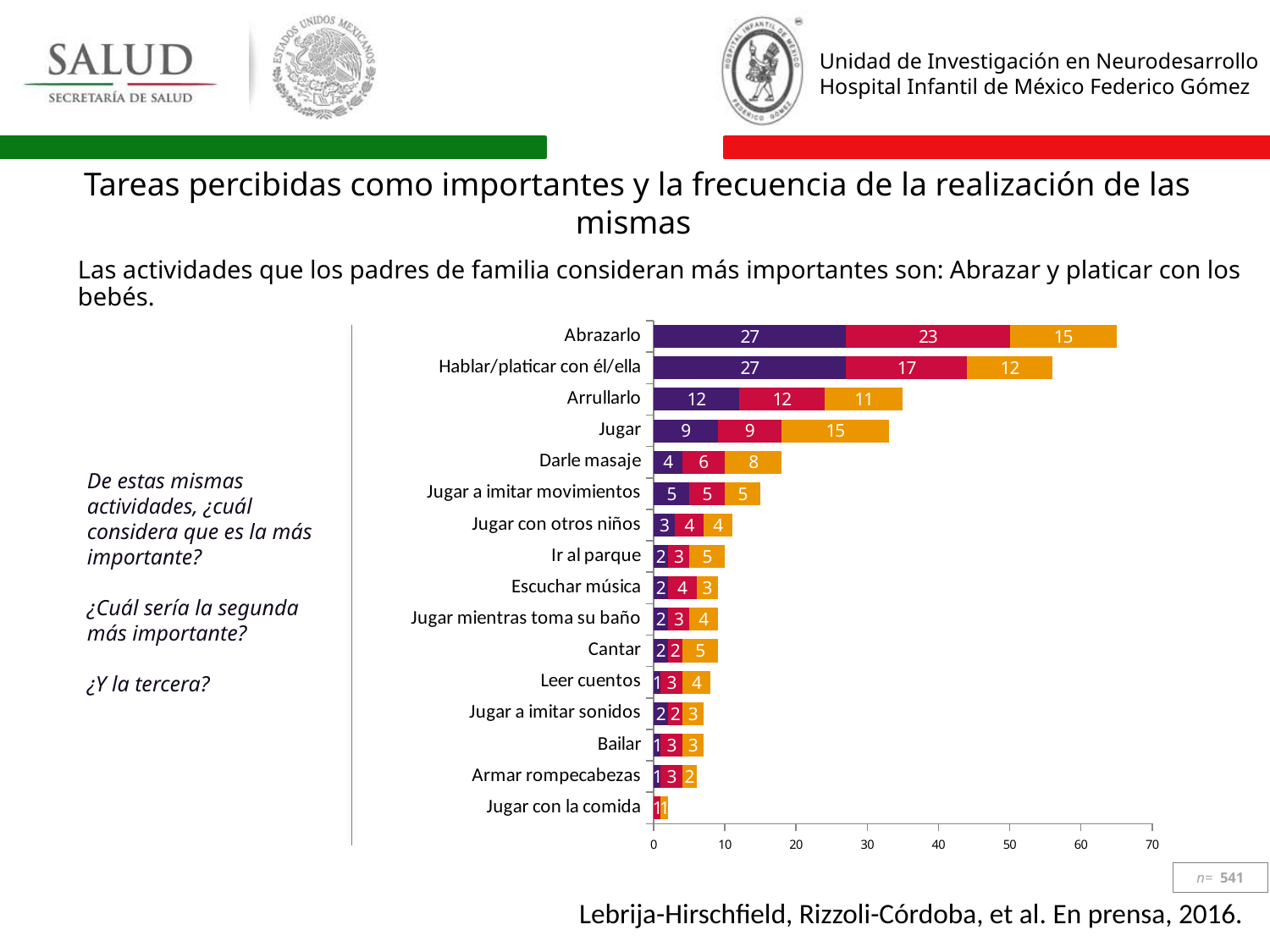
Is the total bar for Hablar/platicar con él/ella greater or less than 50? greater What is the value of the middle (red) segment for Hablar/platicar con él/ella? 17 How many activities (categories) are listed on the chart? 16 What is the total of the stacked bar for Abrazarlo? 65 Which activity has the shortest total bar? Jugar con la comida Which is larger: the total bar for Jugar or the total bar for Darle masaje? Jugar Which activity has the longest total bar? Abrazarlo What kind of chart is shown on the slide? Stacked bar chart What is the value of the last (orange) segment for Jugar? 15 What is the value of the first (purple) segment for Abrazarlo? 27 What is the total of the stacked bar for Arrullarlo? 35 What is the difference between the orange segment for Abrazarlo and the orange segment for Hablar/platicar con él/ella? 3